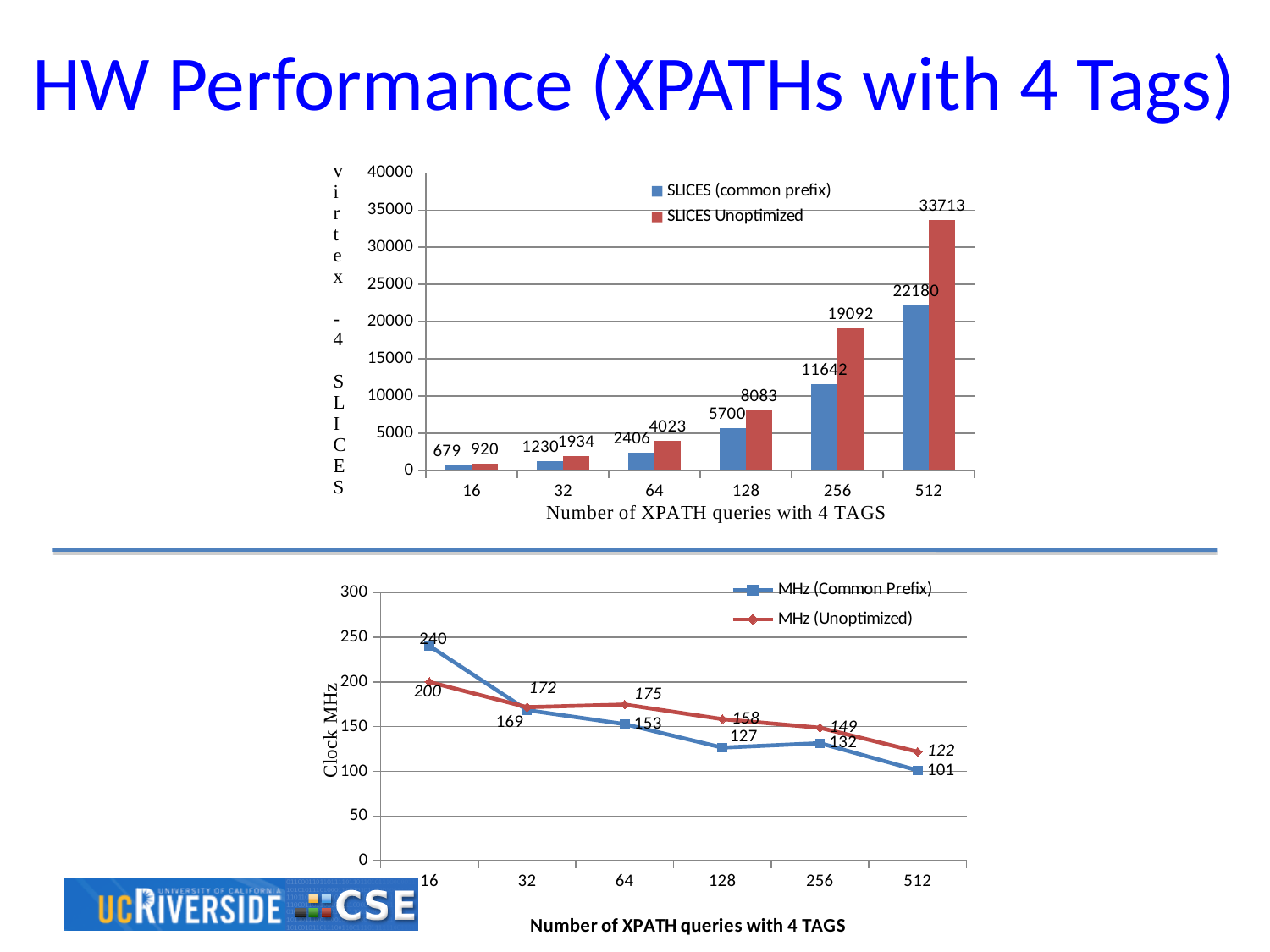
In the bottom chart, what is the MHz (Common Prefix) value at 16 queries? 240 In the top chart, do the SLICES values rise or fall as the number of XPATH queries increases? Rise In the bottom chart, which number of queries has the lowest MHz (Common Prefix) value? 512 In the top chart, what is the value of SLICES Unoptimized for 512 XPATH queries? 33713 In the bottom chart, what is the MHz (Unoptimized) value at 512 queries? 122 What kind of chart is the top chart? Bar chart In the top chart, what is the value of SLICES (common prefix) for 128 XPATH queries? 5700 In the bottom chart, what is the difference between MHz (Unoptimized) and MHz (Common Prefix) at 128 queries? 31 How many x-axis categories does the bottom chart have? 6 In the top chart, how many series does the legend list? 2 In the top chart, what is the difference between SLICES Unoptimized and SLICES (common prefix) at 256 queries? 7450 In the top chart, which series has the larger value at 64 queries, SLICES (common prefix) or SLICES Unoptimized? SLICES Unoptimized